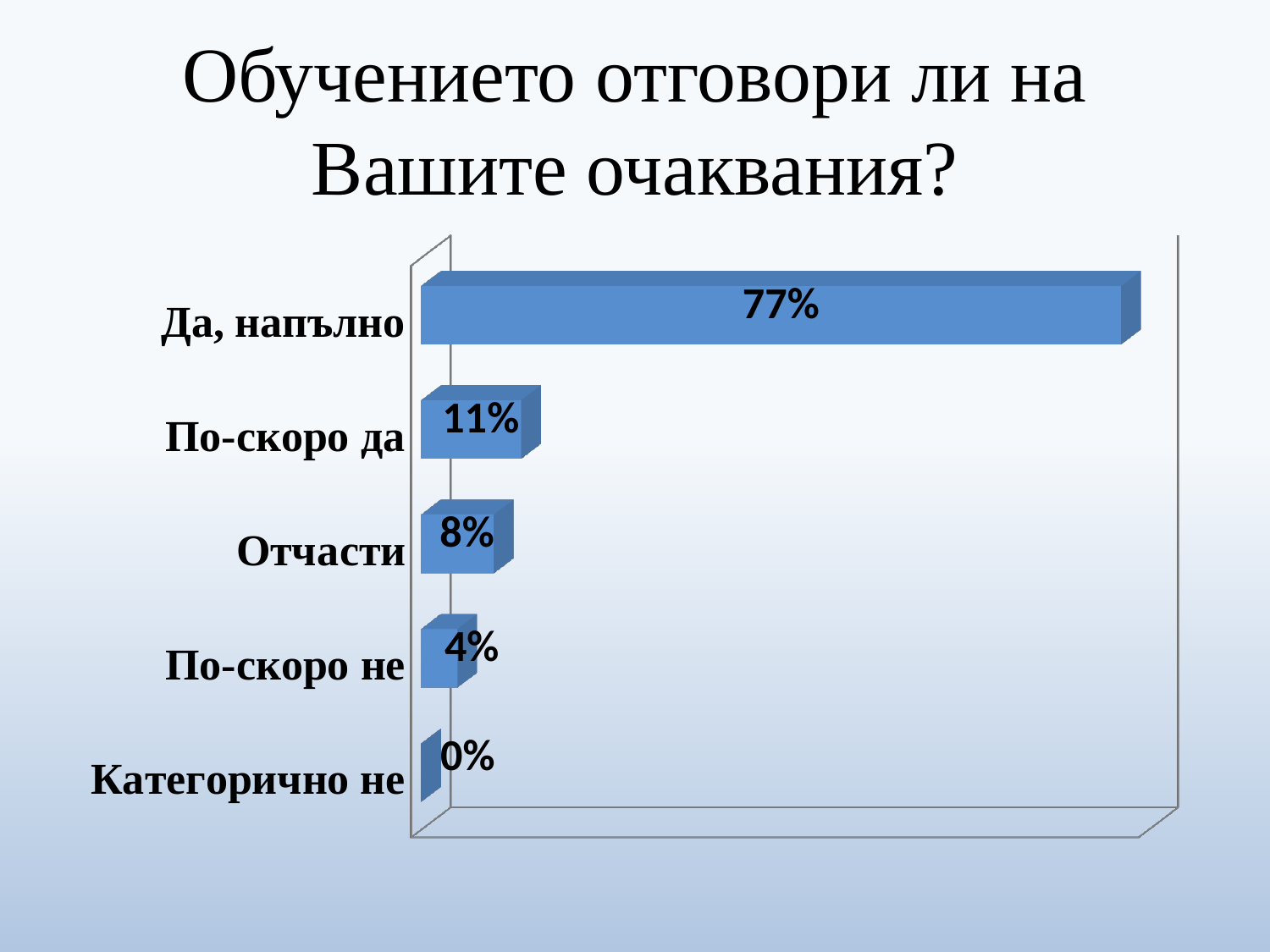
What is the difference between the values for "Отчасти" and "По-скоро не"? 4% Which is larger, the value for "По-скоро да" or the value for "Отчасти"? По-скоро да Which category has the lowest value? Категорично не What is the value for "Отчасти"? 8% What is the value for "Категорично не"? 0% Which category has the highest value? Да, напълно What kind of chart is shown on the slide? Bar chart What is the difference between the values for "Да, напълно" and "По-скоро да"? 66% What is the value for "Да, напълно"? 77% What is the value for "По-скоро не"? 4% How many categories are shown in the chart? 5 What is the value for "По-скоро да"? 11%